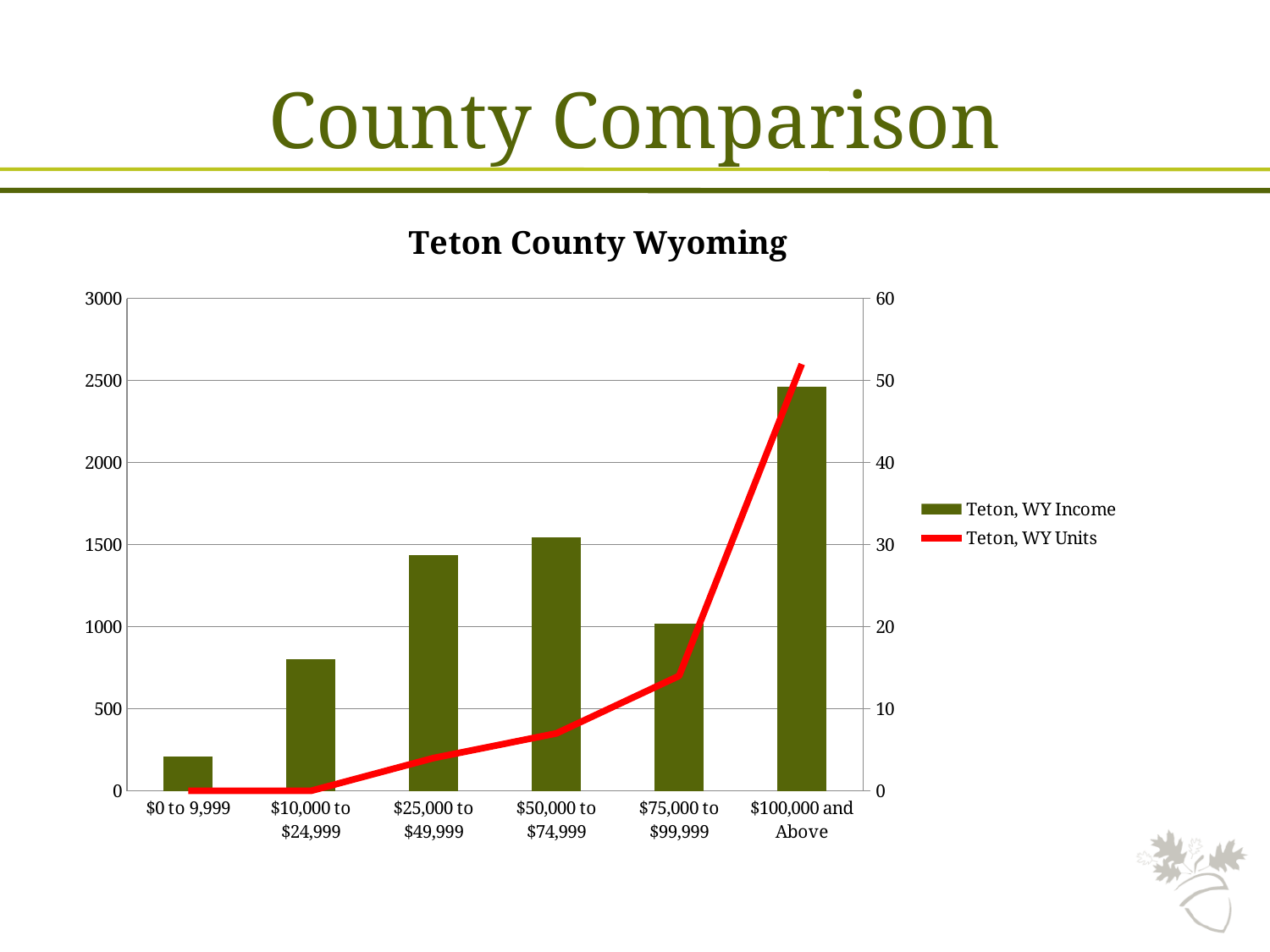
What kind of chart is used to show the Teton, WY Income series? bar chart Does the Teton, WY Units line rise or fall from left to right across the income categories? rise Which has the larger Teton, WY Income value: $25,000 to $49,999 or $75,000 to $99,999? $25,000 to $49,999 Which income category has the lowest Teton, WY Income bar? $0 to 9,999 Is the Teton, WY Units value for $75,000 to $99,999 greater or less than 20? less What kind of chart is used to show the Teton, WY Units series? line chart How many income categories are shown on the x axis? 6 Which income category has the highest Teton, WY Income bar? $100,000 and Above Is the Teton, WY Income value for $100,000 and Above greater or less than 2000? greater Is the Teton, WY Income value for $10,000 to $24,999 greater or less than 1000? less How many series does the legend list? 2 What is the title of the chart? Teton County Wyoming